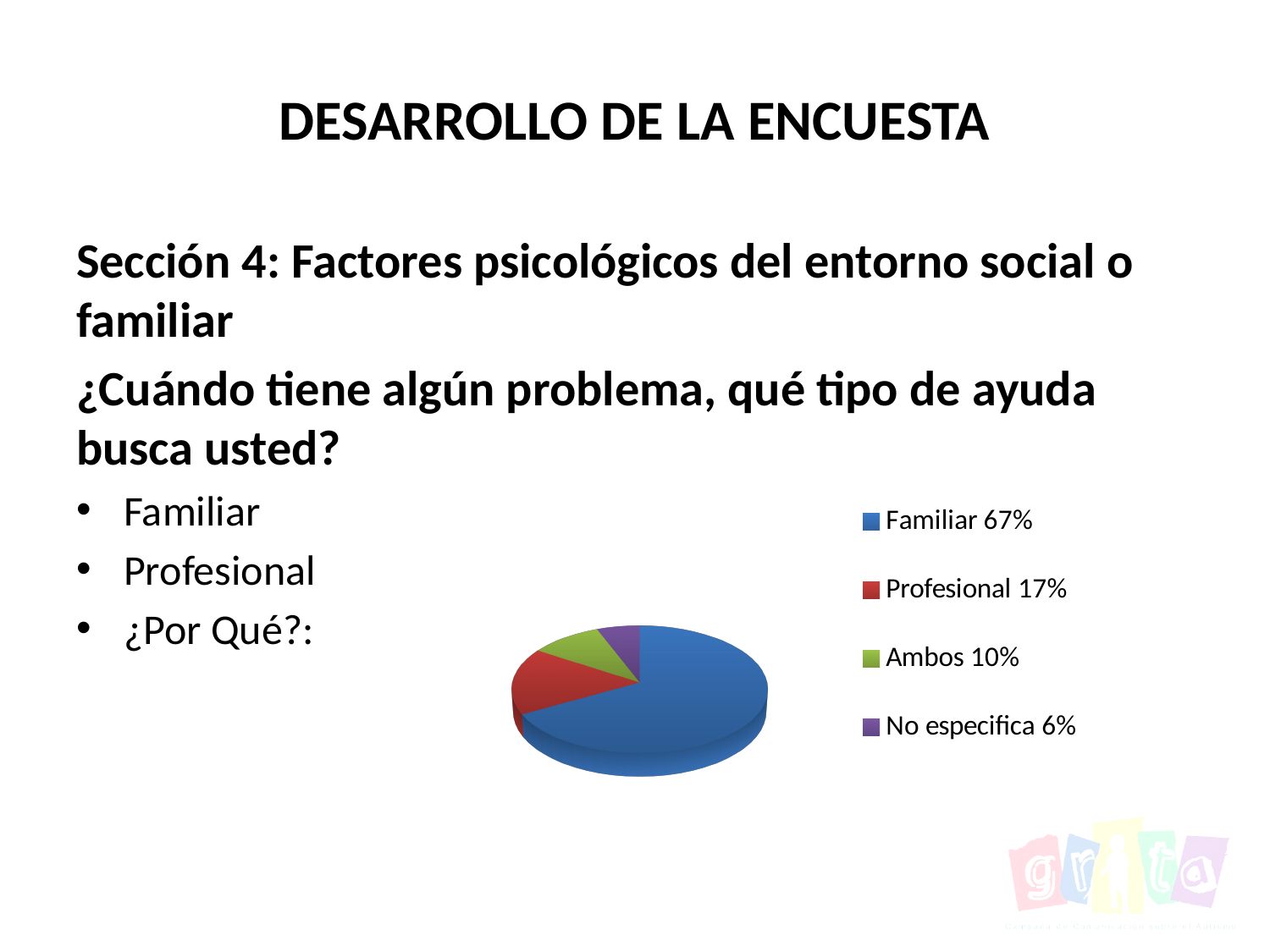
What share of the pie does Ambos represent? 10% What is the difference in percentage points between Ambos and No especifica? 4 What share of the pie does Profesional represent? 17% What share of the pie does No especifica represent? 6% Which category has the largest slice of the pie? Familiar Which category has the smallest slice of the pie? No especifica Which is larger, the share for Profesional or the share for Ambos? Profesional What is the difference in percentage points between Familiar and Profesional? 50 What colour is the slice for Familiar? blue How many categories does the pie chart show? 4 What kind of chart is shown on the slide? pie chart